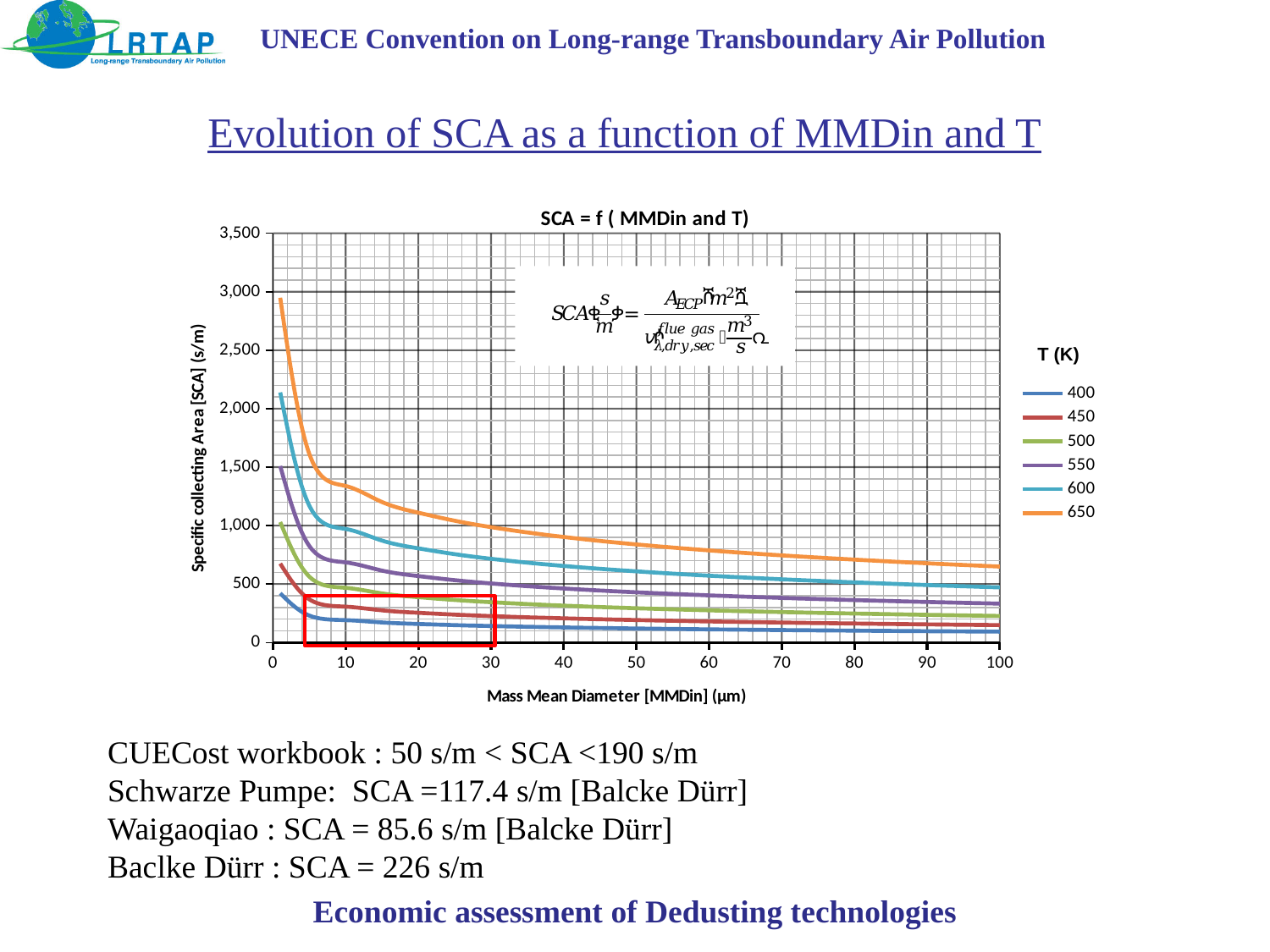
How many series does the legend of the chart list? 6 Is the value of the 650 series at MMDin = 10 greater or less than 1,000? greater What is the title of the chart? SCA = f ( MMDin and T) At MMDin = 50, which series has the larger SCA value, 650 or 400? 650 What is the label of the x axis of the chart? Mass Mean Diameter [MMDin] (µm) Which temperature series has the highest SCA values across the chart? 650 Which temperature series has the lowest SCA values across the chart? 400 What kind of chart is shown on the slide? line chart Do the SCA values rise or fall as Mass Mean Diameter increases along the x axis? fall Is the value of the 650 series at MMDin = 1 greater or less than 2,500? greater Is the value of the 400 series at MMDin = 100 greater or less than 500? less